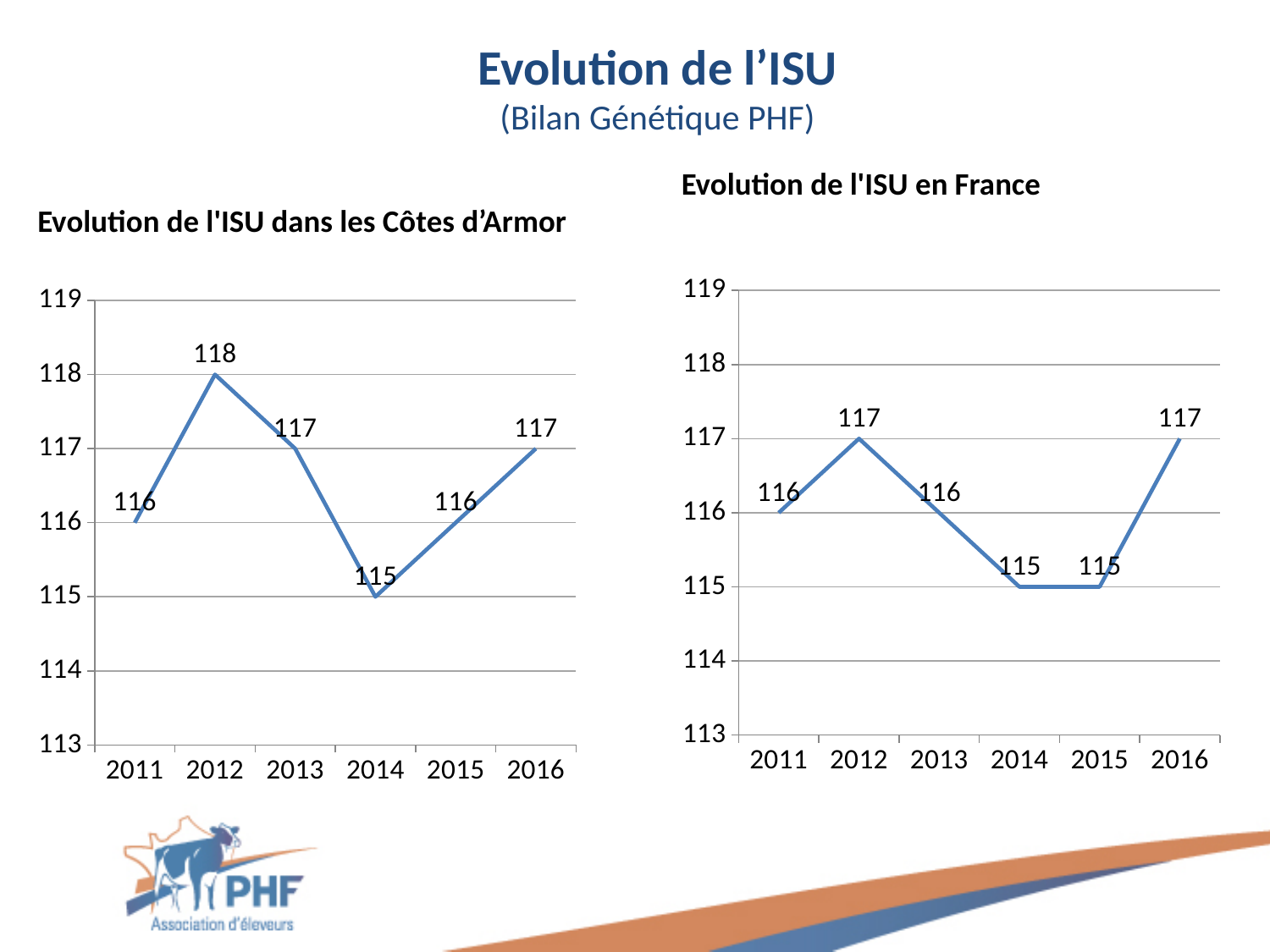
In the chart 'Evolution de l'ISU en France', which year has the highest value? 2012 and 2016 In the chart 'Evolution de l'ISU en France', is the value for 2013 greater or less than 117? less In the chart 'Evolution de l'ISU dans les Côtes d'Armor', which year has the highest value? 2012 In the chart 'Evolution de l'ISU dans les Côtes d'Armor', which year has the lowest value? 2014 In the chart 'Evolution de l'ISU en France', do the values rise or fall from 2015 to 2016? rise In the chart 'Evolution de l'ISU en France', what is the value for 2014? 115 How many years are plotted in the chart 'Evolution de l'ISU dans les Côtes d'Armor'? 6 What kind of chart is 'Evolution de l'ISU en France'? line chart In the chart 'Evolution de l'ISU en France', what is the difference between the values for 2016 and 2015? 2 In the chart 'Evolution de l'ISU dans les Côtes d'Armor', what is the difference between the values for 2012 and 2014? 3 Which is larger: the 2012 value in the Côtes d'Armor chart or the 2012 value in the France chart? Côtes d'Armor In the chart 'Evolution de l'ISU dans les Côtes d'Armor', what is the value for 2012? 118